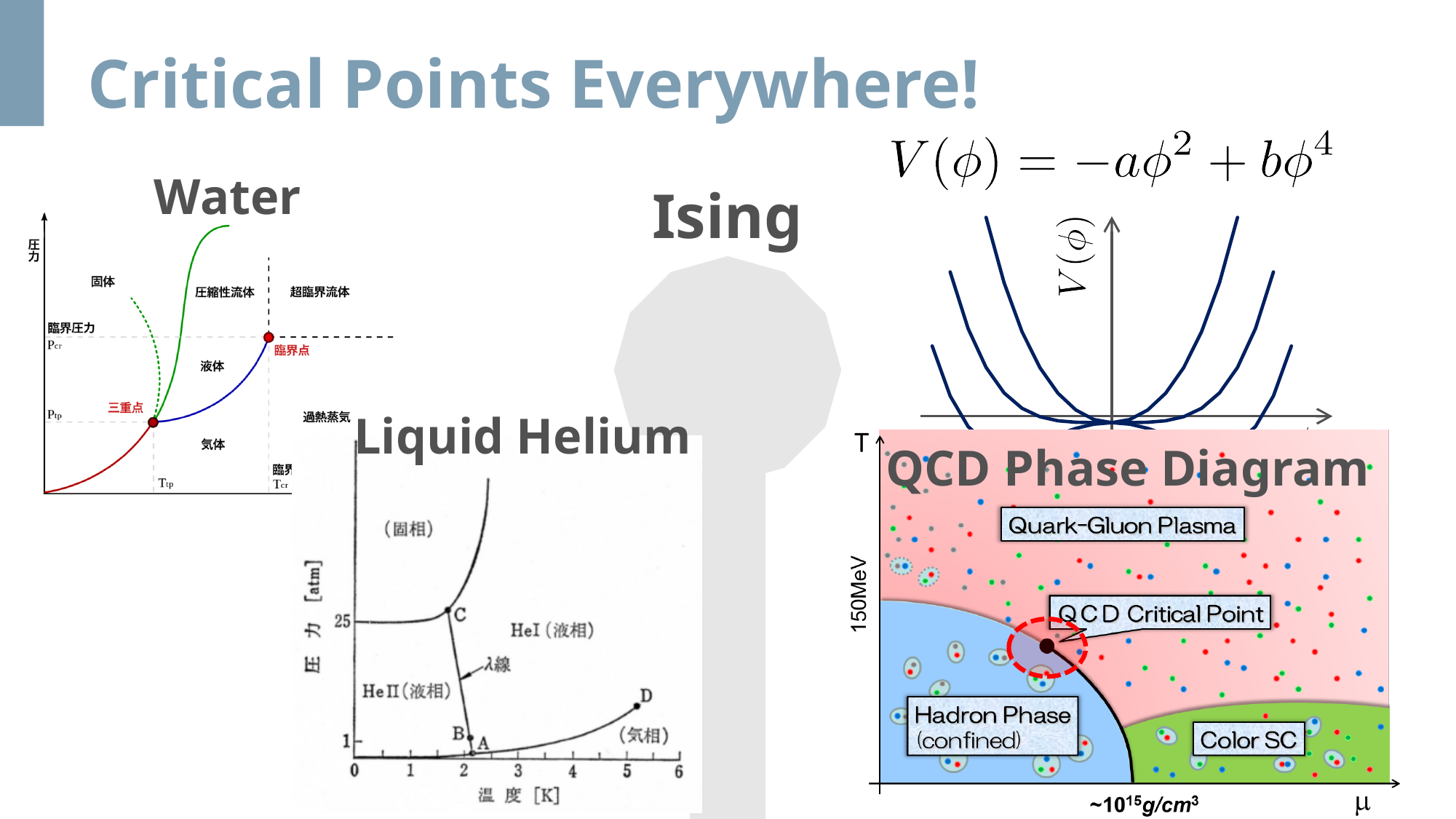
In the Liquid Helium diagram, is the pressure at point A greater or less than 25 atm? less In the Ising plot of V(φ), how many curves are drawn? 3 In the Liquid Helium diagram, how many labeled points (letters) are marked on the curves? 4 In the QCD Phase Diagram, what density value is marked on the μ axis? ~10¹⁵g/cm³ In the Liquid Helium diagram, is the temperature at point D greater or less than 4 K? greater In the Liquid Helium diagram, which point is at a higher temperature, C or D? D In the QCD Phase Diagram, how many phases are labeled? 3 In the Liquid Helium diagram, what is the x-axis label? 温度 [K] In the QCD Phase Diagram, which phase occupies the high-temperature region? Quark-Gluon Plasma What kind of diagram is the Liquid Helium chart? phase diagram In the Liquid Helium diagram, what pressure (in atm) is marked at point C? 25 In the QCD Phase Diagram, what temperature value is marked on the T axis? 150MeV